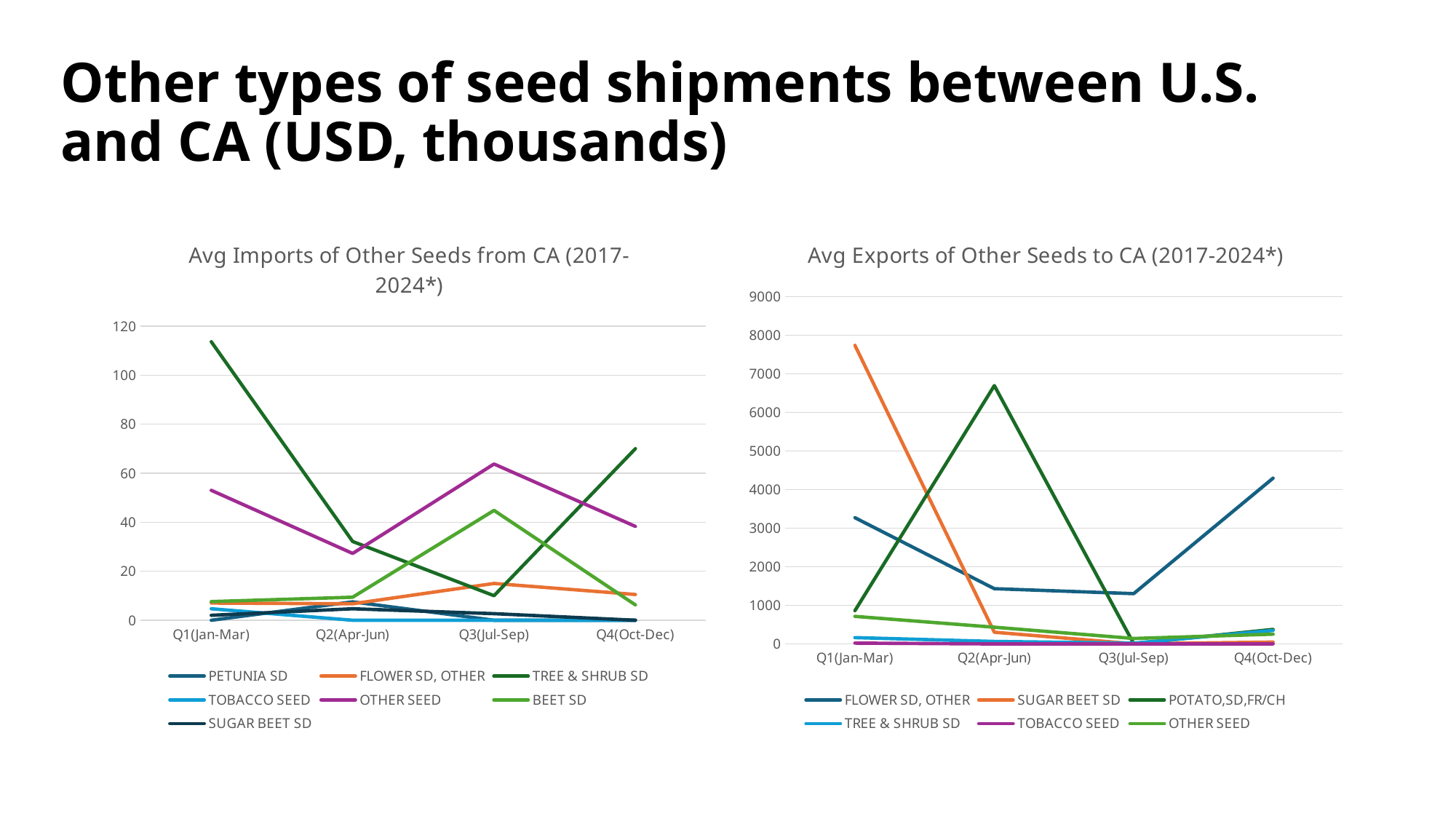
In the 'Avg Exports of Other Seeds to CA (2017-2024*)' chart, is the value for SUGAR BEET SD at Q1(Jan-Mar) greater or less than 7000? greater How many series does the legend of the 'Avg Imports of Other Seeds from CA (2017-2024*)' chart list? 7 How many series does the legend of the 'Avg Exports of Other Seeds to CA (2017-2024*)' chart list? 6 In the 'Avg Imports of Other Seeds from CA (2017-2024*)' chart, at Q4(Oct-Dec), which is larger: TREE & SHRUB SD or OTHER SEED? TREE & SHRUB SD In the 'Avg Imports of Other Seeds from CA (2017-2024*)' chart, which series has the highest value at Q1(Jan-Mar)? TREE & SHRUB SD In the 'Avg Exports of Other Seeds to CA (2017-2024*)' chart, which series has the highest value at Q1(Jan-Mar)? SUGAR BEET SD In the 'Avg Exports of Other Seeds to CA (2017-2024*)' chart, which series has the highest value at Q2(Apr-Jun)? POTATO,SD,FR/CH In the 'Avg Exports of Other Seeds to CA (2017-2024*)' chart, is the value for FLOWER SD, OTHER at Q4(Oct-Dec) greater or less than 4000? greater In the 'Avg Exports of Other Seeds to CA (2017-2024*)' chart, does the SUGAR BEET SD line rise or fall from Q1(Jan-Mar) to Q3(Jul-Sep)? Fall How many quarters are shown on the x axis of the 'Avg Exports of Other Seeds to CA (2017-2024*)' chart? 4 In the 'Avg Imports of Other Seeds from CA (2017-2024*)' chart, is the value for TREE & SHRUB SD at Q1(Jan-Mar) greater or less than 100? greater What kind of chart is the 'Avg Imports of Other Seeds from CA (2017-2024*)' chart? Line chart